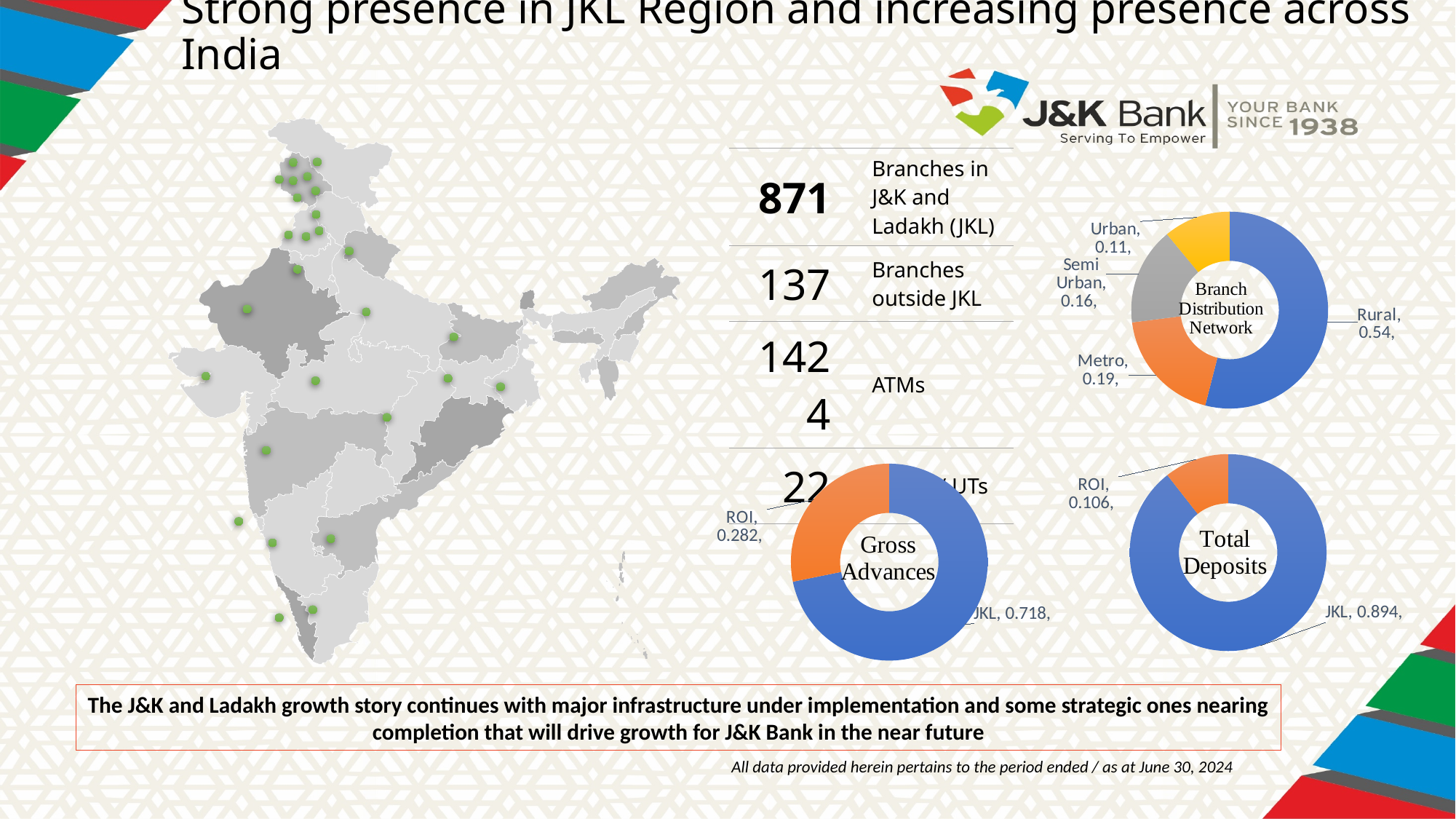
In the Branch Distribution Network chart, what is the value for Metro? 0.19 In the Branch Distribution Network chart, what is the difference between the Rural and Metro values? 0.35 What type of chart is the Total Deposits chart? Doughnut chart Which is larger: the JKL value in the Gross Advances chart or the JKL value in the Total Deposits chart? Total Deposits In the Branch Distribution Network chart, what is the value for Rural? 0.54 In the Branch Distribution Network chart, which category has the smallest share? Urban In the Total Deposits chart, what is the value for ROI? 0.106 In the Branch Distribution Network chart, which category has the largest share? Rural In the Gross Advances chart, what is the value for ROI? 0.282 In the Gross Advances chart, what is the value for JKL? 0.718 How many categories are shown in the Branch Distribution Network chart? 4 In the Branch Distribution Network chart, what is the value for Semi Urban? 0.16